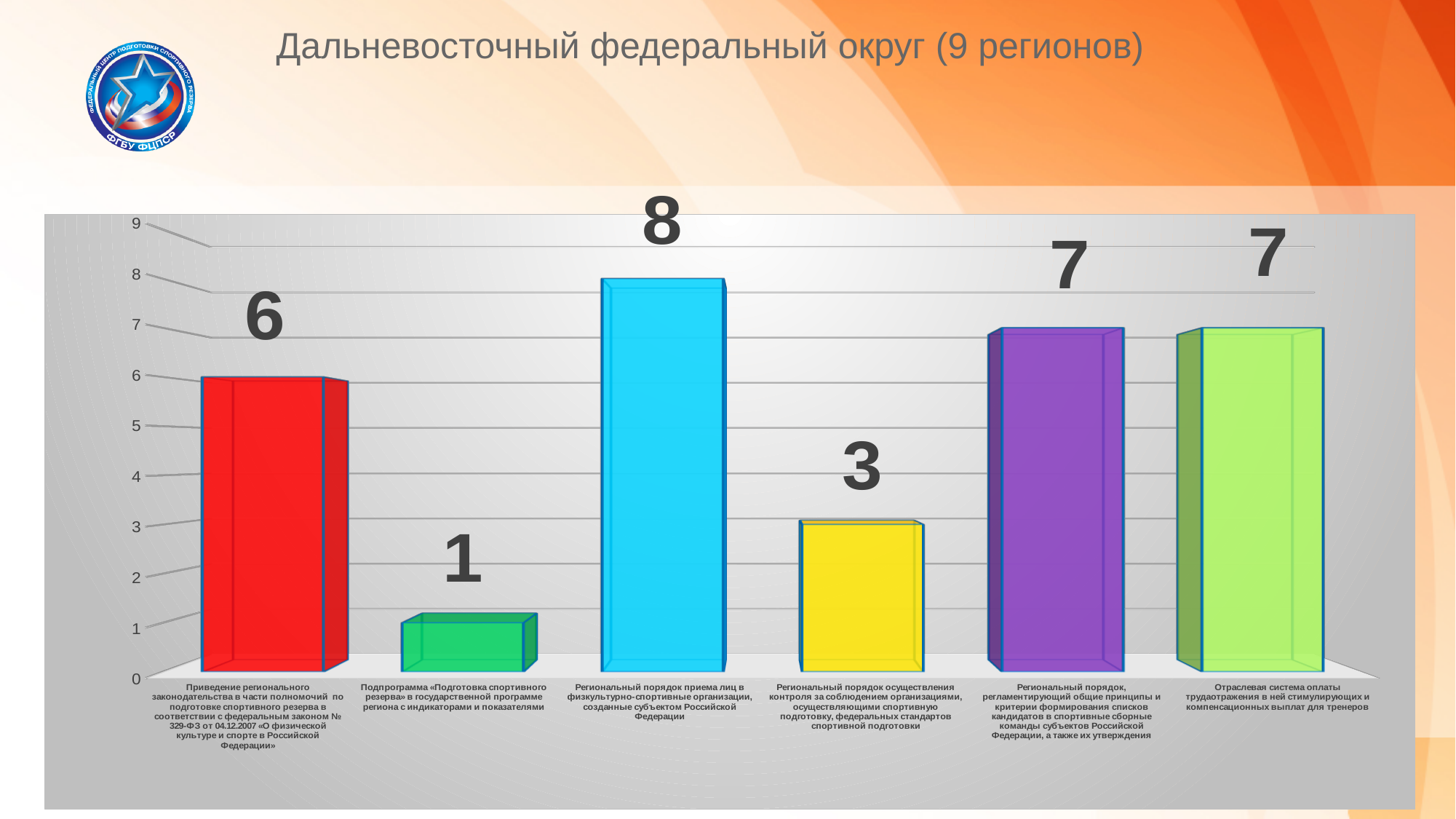
What is the difference between the value for the first bar (Приведение регионального законодательства...) and the value for the second bar (Подпрограмма «Подготовка спортивного резерва»...)? 5 Which category has the highest value? Региональный порядок приема лиц в физкультурно-спортивные организации, созданные субъектом Российской Федерации What is the value for «Региональный порядок приема лиц в физкультурно-спортивные организации, созданные субъектом Российской Федерации»? 8 What colour is the bar for «Региональный порядок приема лиц в физкультурно-спортивные организации...»? Light blue (cyan) Which category has the lowest value? Подпрограмма «Подготовка спортивного резерва» в государственной программе региона с индикаторами и показателями What is the title of the slide? Дальневосточный федеральный округ (9 регионов) Which is larger: the value for «Региональный порядок приема лиц...» or the value for «Региональный порядок осуществления контроля...»? Региональный порядок приема лиц в физкультурно-спортивные организации, созданные субъектом Российской Федерации What kind of chart is shown on the slide? Bar chart What is the value for «Отраслевая система оплаты труда» (the rightmost bar)? 7 How many categories are shown in the chart? 6 What is the value for «Подпрограмма «Подготовка спортивного резерва» в государственной программе региона с индикаторами и показателями»? 1 What is the value for «Региональный порядок осуществления контроля за соблюдением организациями, осуществляющими спортивную подготовку, федеральных стандартов спортивной подготовки»? 3